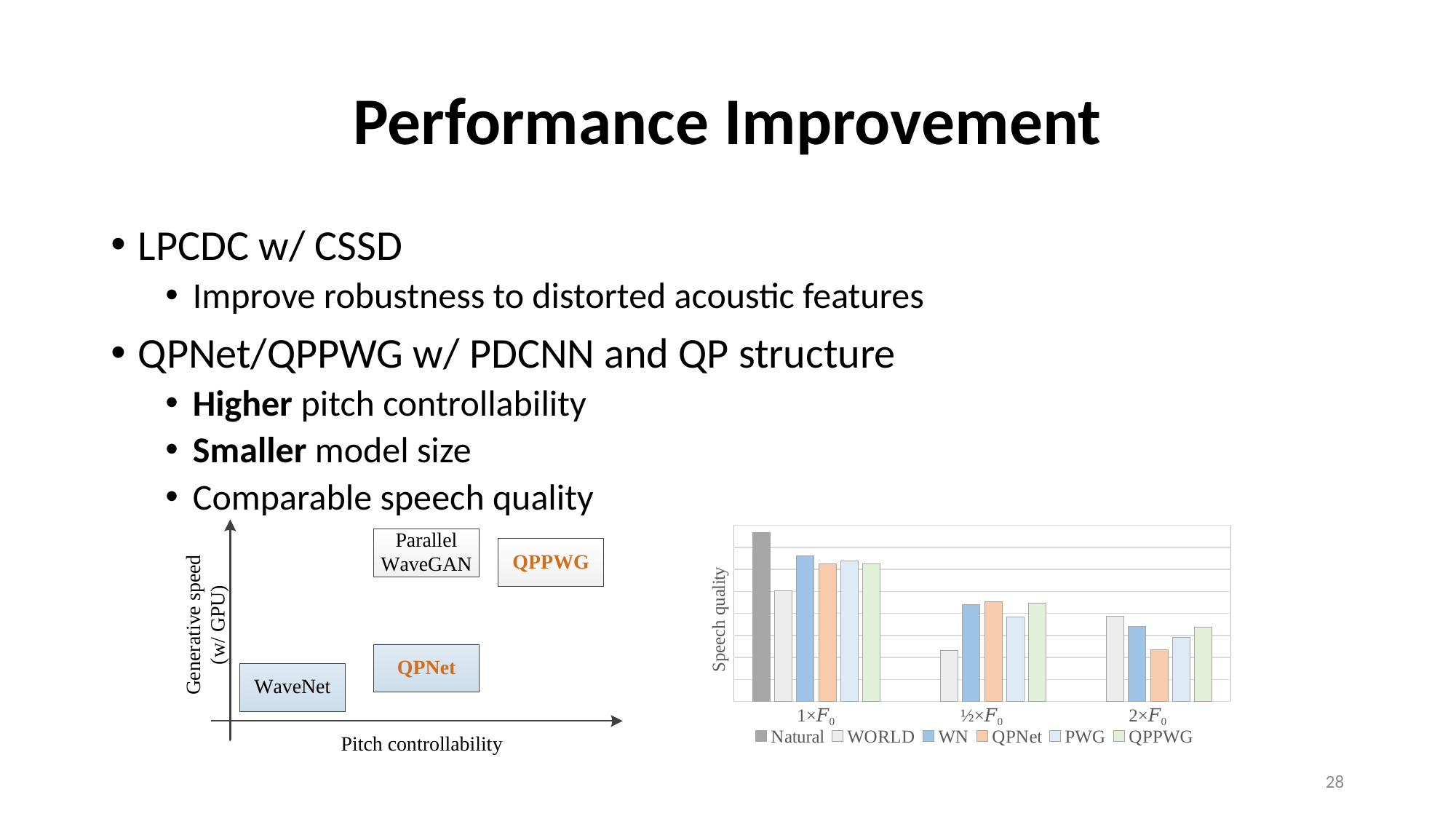
In the bar chart on the right, how many categories are shown on the x axis? 3 In the bar chart on the right, which series has the lowest bar in the ½×F0 group? WORLD In the bar chart on the right, which series has the lowest bar in the 1×F0 group? WORLD What is the y-axis label of the bar chart on the right? Speech quality What kind of chart is the chart on the right of the slide? bar chart In the bar chart on the right, which series has the lowest bar in the 2×F0 group? QPNet What is the x-axis label of the diagram on the left of the slide? Pitch controllability In the bar chart on the right, is the WORLD bar or the QPNet bar higher in the 2×F0 group? WORLD In the bar chart on the right, how many series does the legend list? 6 In the bar chart on the right, is the QPNet bar higher in the 1×F0 group or the ½×F0 group? 1×F0 In the bar chart on the right, is the WN bar or the WORLD bar higher in the ½×F0 group? WN In the bar chart on the right, which series has the highest bar in the 1×F0 group? Natural